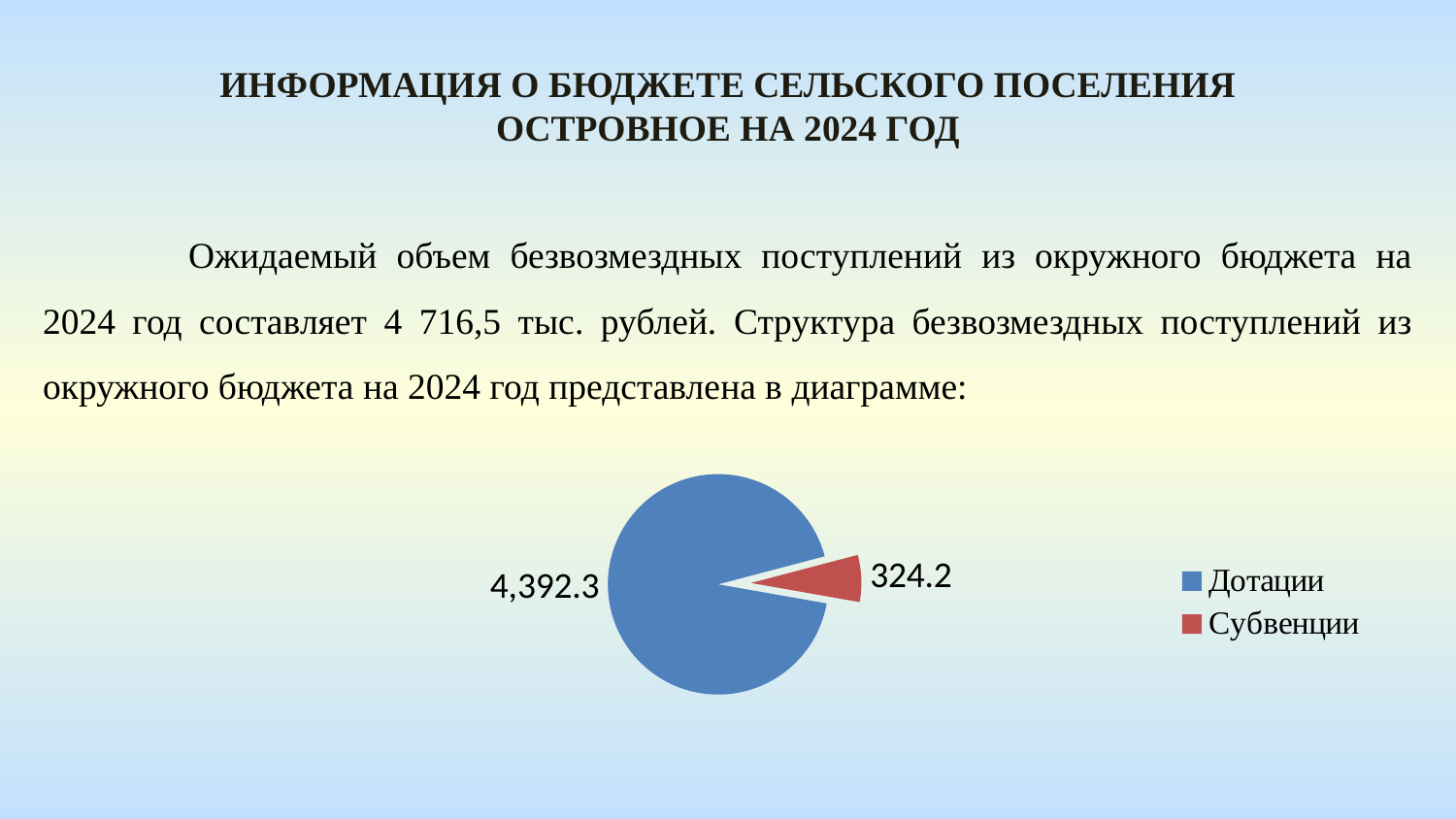
What is the total of the two slices in the pie chart? 4,716.5 What is the value for Субвенции in the pie chart? 324.2 What colour is the Дотации slice? blue Which is larger, Дотации or Субвенции? Дотации Which category has the largest slice in the pie chart? Дотации How many slices does the pie chart have? 2 What is the value for Дотации in the pie chart? 4,392.3 What is the difference between the values for Дотации and Субвенции? 4,068.1 How many entries does the legend list? 2 Which category has the smallest slice in the pie chart? Субвенции What colour is the Субвенции slice? red What kind of chart is shown on the slide? pie chart